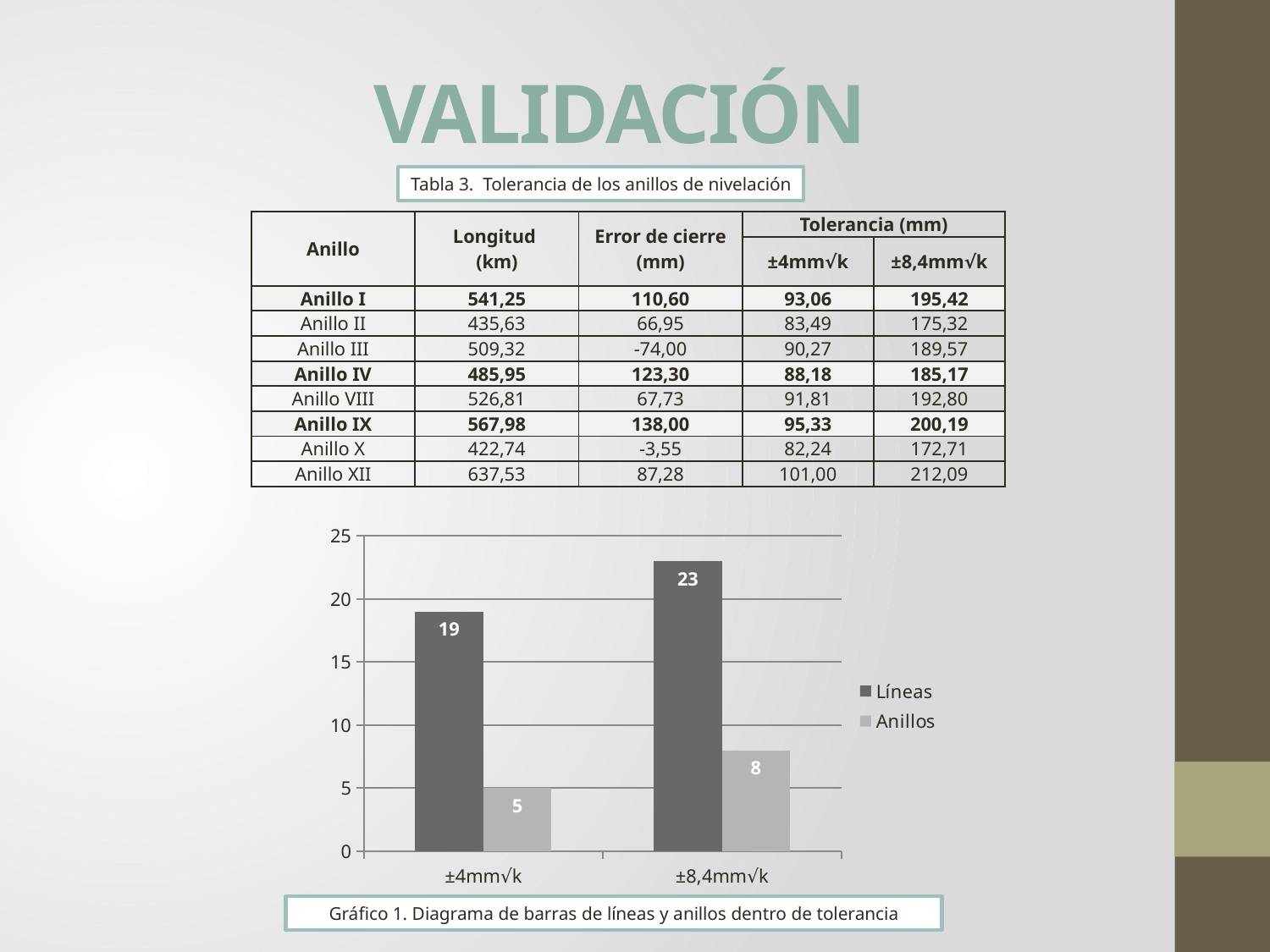
Which category has the highest Líneas value in the bar chart? ±8,4mm√k How many series does the legend of the bar chart list? 2 What is the difference between Líneas and Anillos at ±4mm√k? 14 What is the difference between the Líneas values at ±8,4mm√k and ±4mm√k? 4 What is the value for Líneas at ±4mm√k in the bar chart? 19 Do the Anillos values rise or fall from ±4mm√k to ±8,4mm√k? Rise What is the value for Líneas at ±8,4mm√k in the bar chart? 23 Which category has the lowest Anillos value in the bar chart? ±4mm√k What is the value for Anillos at ±4mm√k in the bar chart? 5 Which is larger at ±8,4mm√k, Líneas or Anillos? Líneas What is the value for Anillos at ±8,4mm√k in the bar chart? 8 What kind of chart is shown on the slide? Bar chart